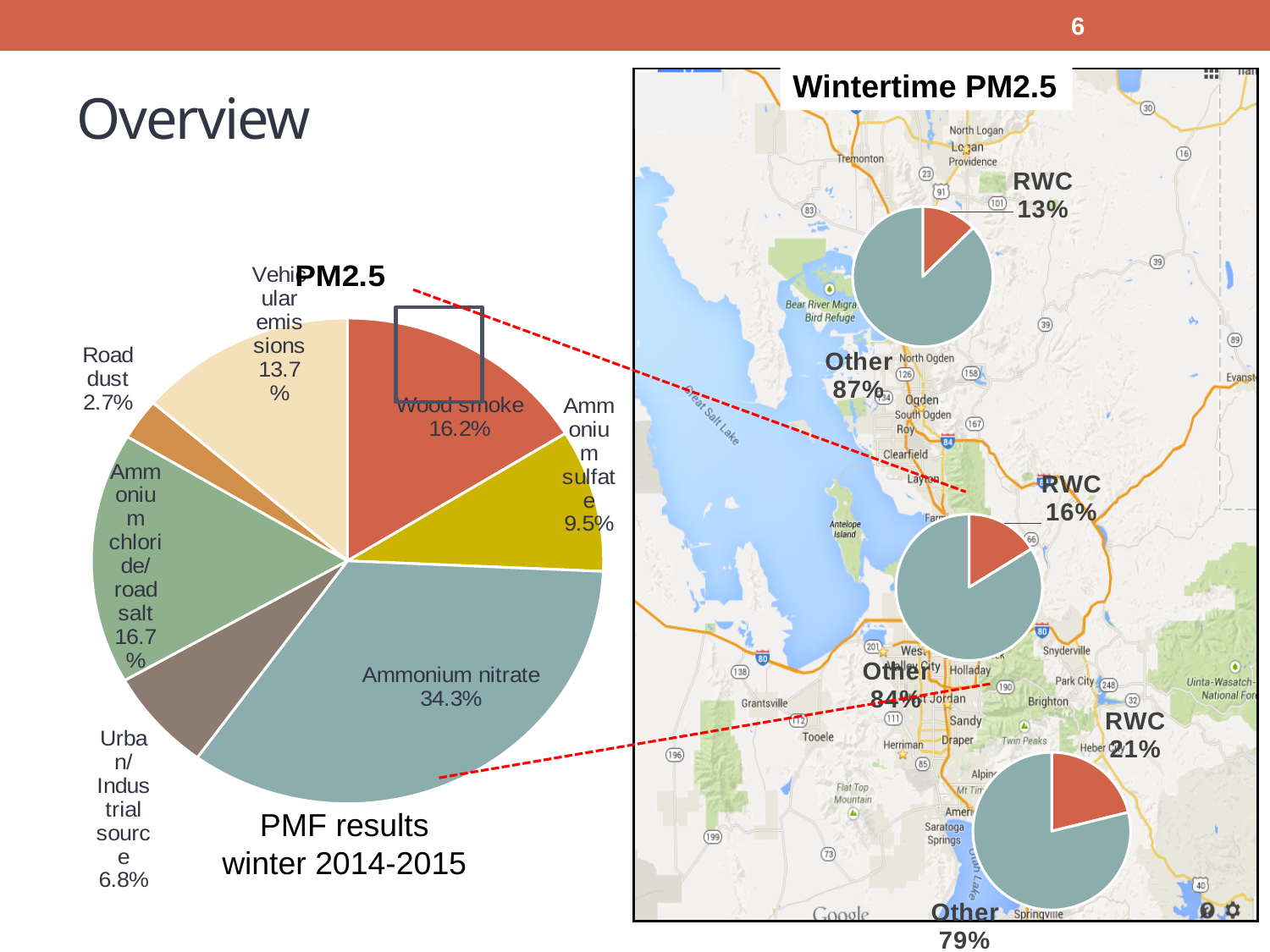
What kind of chart is the PM2.5 chart on the left? Pie chart In the PM2.5 pie chart on the left, how many slices are there? 7 In the PM2.5 pie chart on the left, which category has the smallest share? Road dust In the PM2.5 pie chart on the left, which is larger: Vehicular emissions or Ammonium sulfate? Vehicular emissions In the PM2.5 pie chart on the left, what share is Road dust? 2.7% In the PM2.5 pie chart on the left, what is the difference between the Ammonium nitrate share and the Wood smoke share? 18.1% In the topmost small pie chart on the map (near Logan), what share is RWC? 13% In the PM2.5 pie chart on the left, what share is Wood smoke? 16.2% In the middle small pie chart on the map (near Salt Lake City), what share is RWC? 16% In the PM2.5 pie chart on the left, what share is Ammonium nitrate? 34.3% In the PM2.5 pie chart on the left, which category has the largest share? Ammonium nitrate In the bottom small pie chart on the map (near Provo), what share is Other? 79%